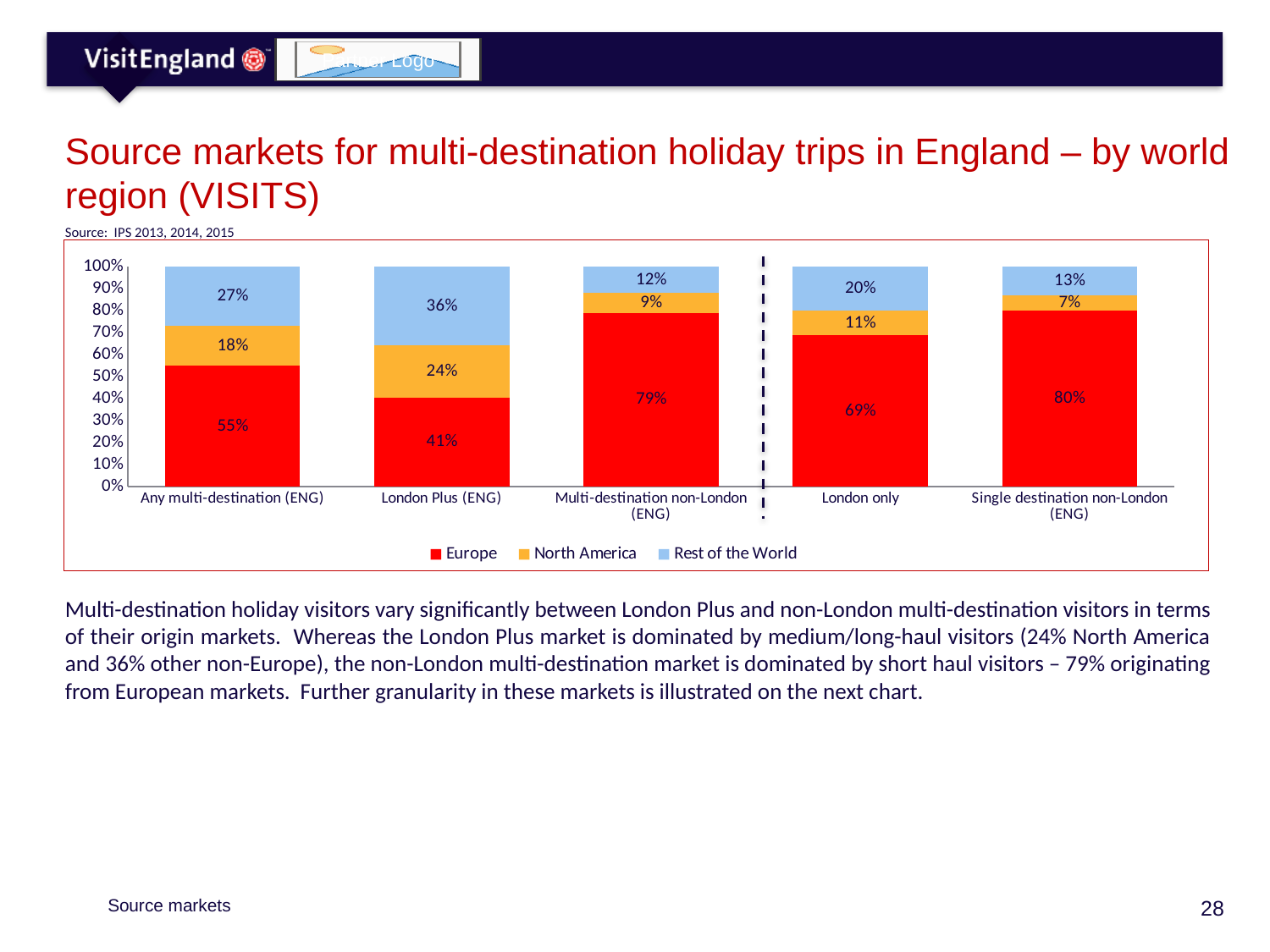
Which colour represents Europe in the chart? Red What is the Europe share for London only? 69% What percentage of Any multi-destination (ENG) visits come from Europe? 55% What is the difference between the Rest of the World share for London Plus (ENG) and for Single destination non-London (ENG)? 23% What kind of chart is shown on the slide? Stacked bar chart Which category has the highest Europe share? Single destination non-London (ENG) What is the Rest of the World share for Multi-destination non-London (ENG)? 12% How many categories are shown on the x axis? 5 Which category has the lowest Europe share? London Plus (ENG) How many series does the legend list? 3 Which is larger: the North America share for London only or for Multi-destination non-London (ENG)? London only What is the North America share for London Plus (ENG)? 24%